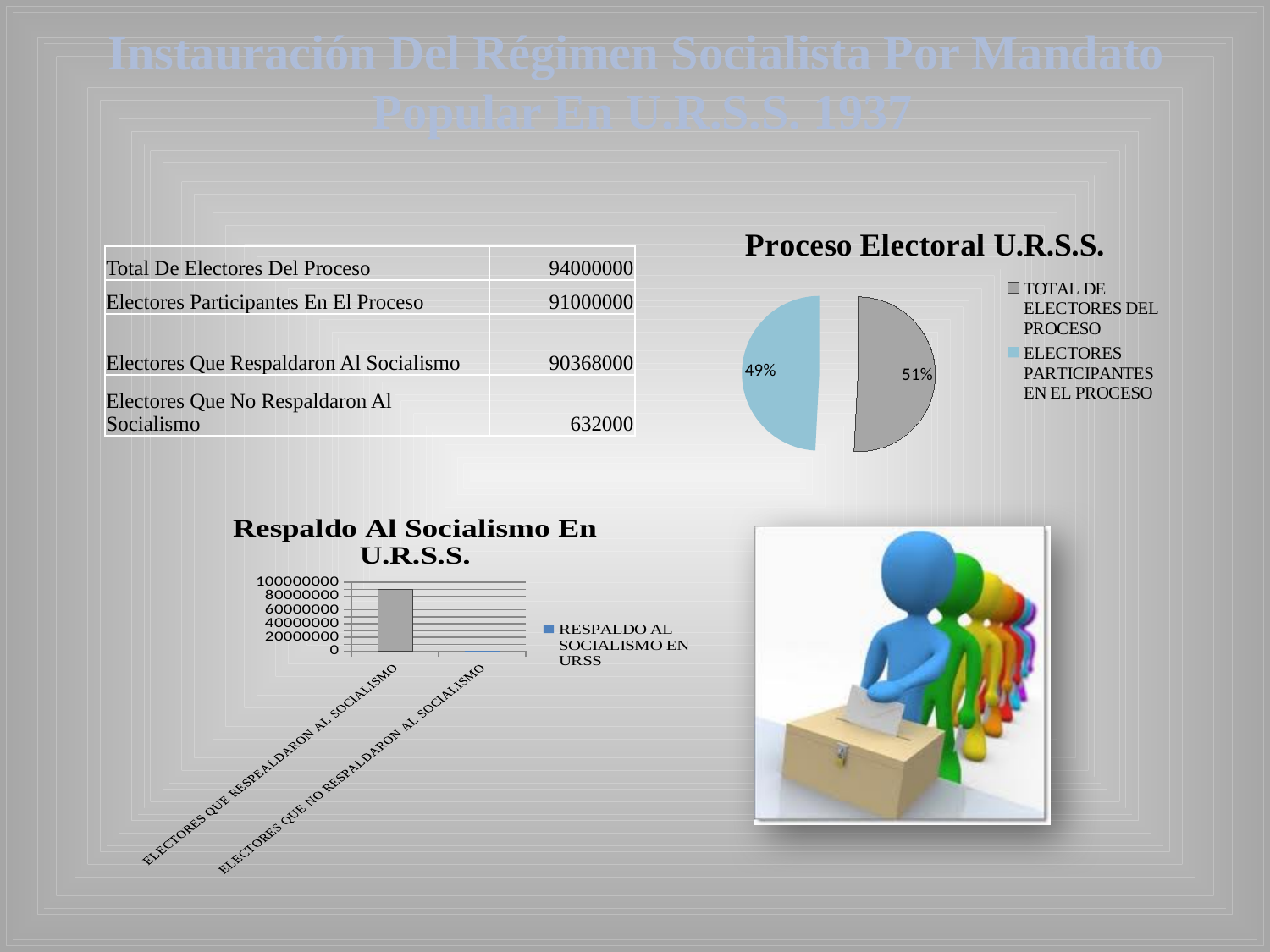
In the bar chart titled "Respaldo Al Socialismo En U.R.S.S.", is the value for ELECTORES QUE NO RESPALDARON AL SOCIALISMO greater or less than 20000000? less In the bar chart titled "Respaldo Al Socialismo En U.R.S.S.", how many categories are shown on the x axis? 2 What kind of chart is the one titled "Respaldo Al Socialismo En U.R.S.S."? Bar chart In the bar chart titled "Respaldo Al Socialismo En U.R.S.S.", which category has the higher value? ELECTORES QUE RESPEALDARON AL SOCIALISMO In the pie chart titled "Proceso Electoral U.R.S.S.", what colour is the slice for ELECTORES PARTICIPANTES EN EL PROCESO? Light blue In the pie chart titled "Proceso Electoral U.R.S.S.", what share is shown for ELECTORES PARTICIPANTES EN EL PROCESO? 49% In the pie chart titled "Proceso Electoral U.R.S.S.", what share is shown for TOTAL DE ELECTORES DEL PROCESO? 51% In the pie chart titled "Proceso Electoral U.R.S.S.", which slice is the largest? TOTAL DE ELECTORES DEL PROCESO In the bar chart titled "Respaldo Al Socialismo En U.R.S.S.", is the value for ELECTORES QUE RESPEALDARON AL SOCIALISMO greater or less than 80000000? greater In the bar chart titled "Respaldo Al Socialismo En U.R.S.S.", how many series does the legend list? 1 In the pie chart titled "Proceso Electoral U.R.S.S.", what is the difference in percentage points between the two slices? 2 percentage points In the pie chart titled "Proceso Electoral U.R.S.S.", how many slices does the pie have? 2